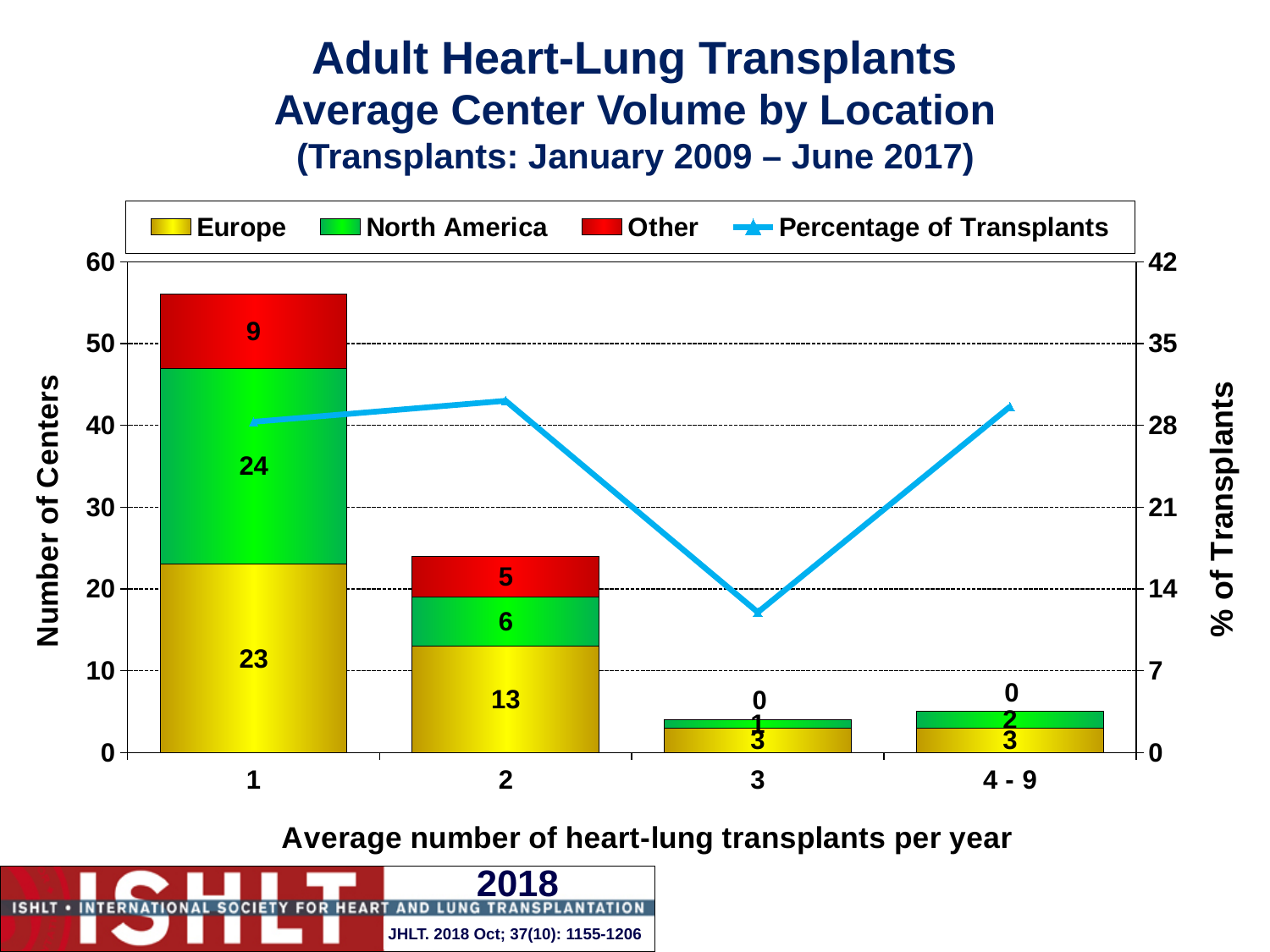
How many centers in Europe have an average of 1 heart-lung transplant per year? 23 What is the North America value for the category '2' average transplants per year? 6 What is the 'Other' value for the category '1' average transplants per year? 9 What is the total number of centers in the stacked bar for category '1'? 56 What is the total number of centers in the stacked bar for category '2'? 24 What is the difference between the Europe values for categories '1' and '2'? 10 What is the label of the right-hand vertical axis? % of Transplants Is the Percentage of Transplants value for category '3' greater or less than 14? less Which category has the tallest stacked bar (most centers)? 1 Which category has the shortest stacked bar (fewest centers)? 3 How many series does the legend list? 4 What is the Europe value for the '4 - 9' category? 3